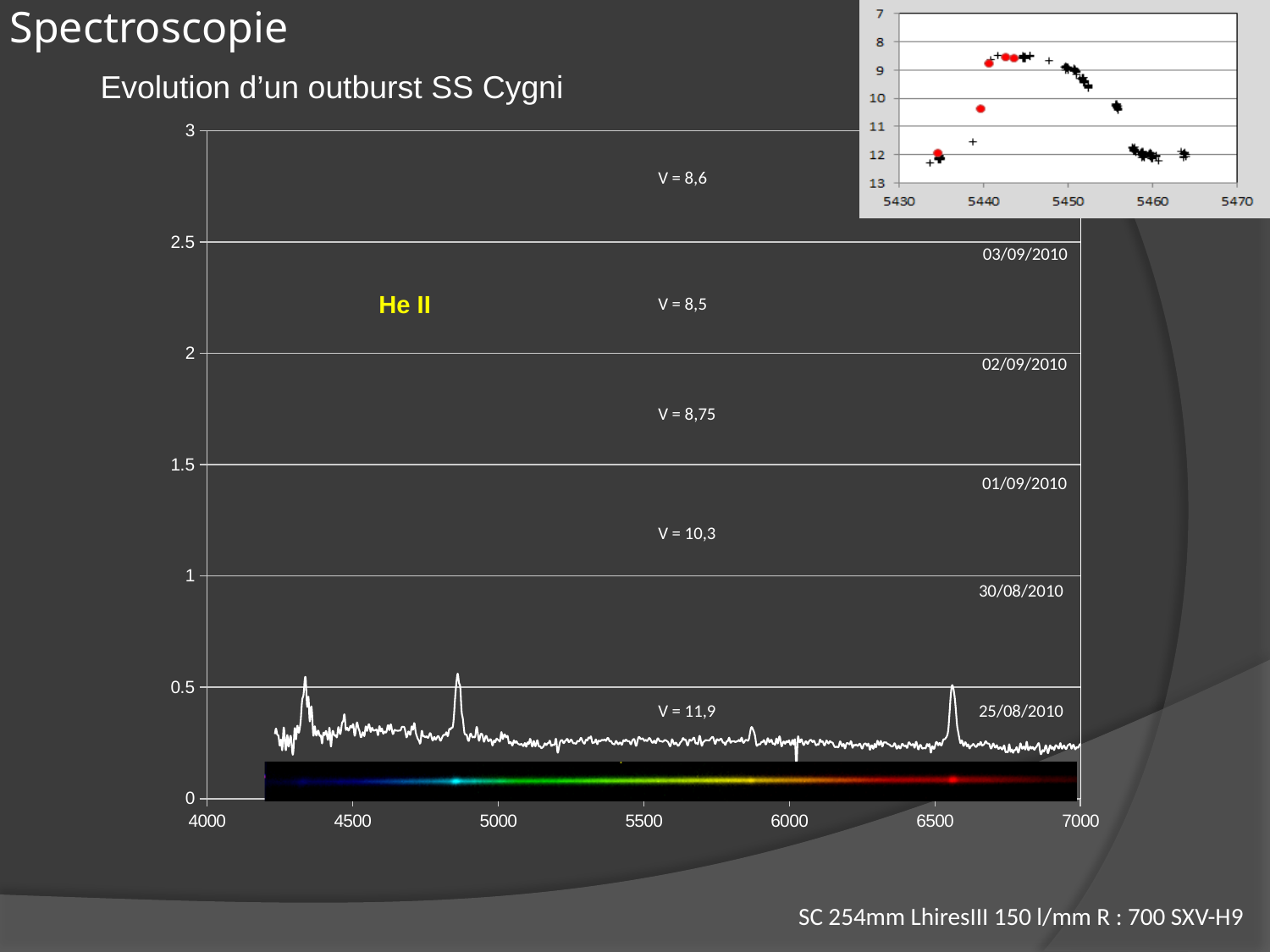
On the main spectrum chart, what V value is labelled for 30/08/2010? V = 10,3 On the main spectrum chart, how many observation dates are labelled? 5 What kind of chart is the inset chart in the top right corner? Scatter chart On the main spectrum chart, which date has the lowest labelled V value? 02/09/2010 On the main spectrum chart, which spectral line is labelled in yellow? He II On the main spectrum chart, which has the larger V value: 01/09/2010 or 30/08/2010? 30/08/2010 On the main spectrum chart, which date has the highest labelled V value? 25/08/2010 On the main spectrum chart, what V value is labelled for 01/09/2010? V = 8,75 On the main spectrum chart, what V value is labelled for 25/08/2010? V = 11,9 What kind of chart is the main spectrum chart? Line chart On the main spectrum chart, what V value is labelled for 03/09/2010? V = 8,6 On the main spectrum chart, what is the difference between the V value for 25/08/2010 and the V value for 03/09/2010? 3,3